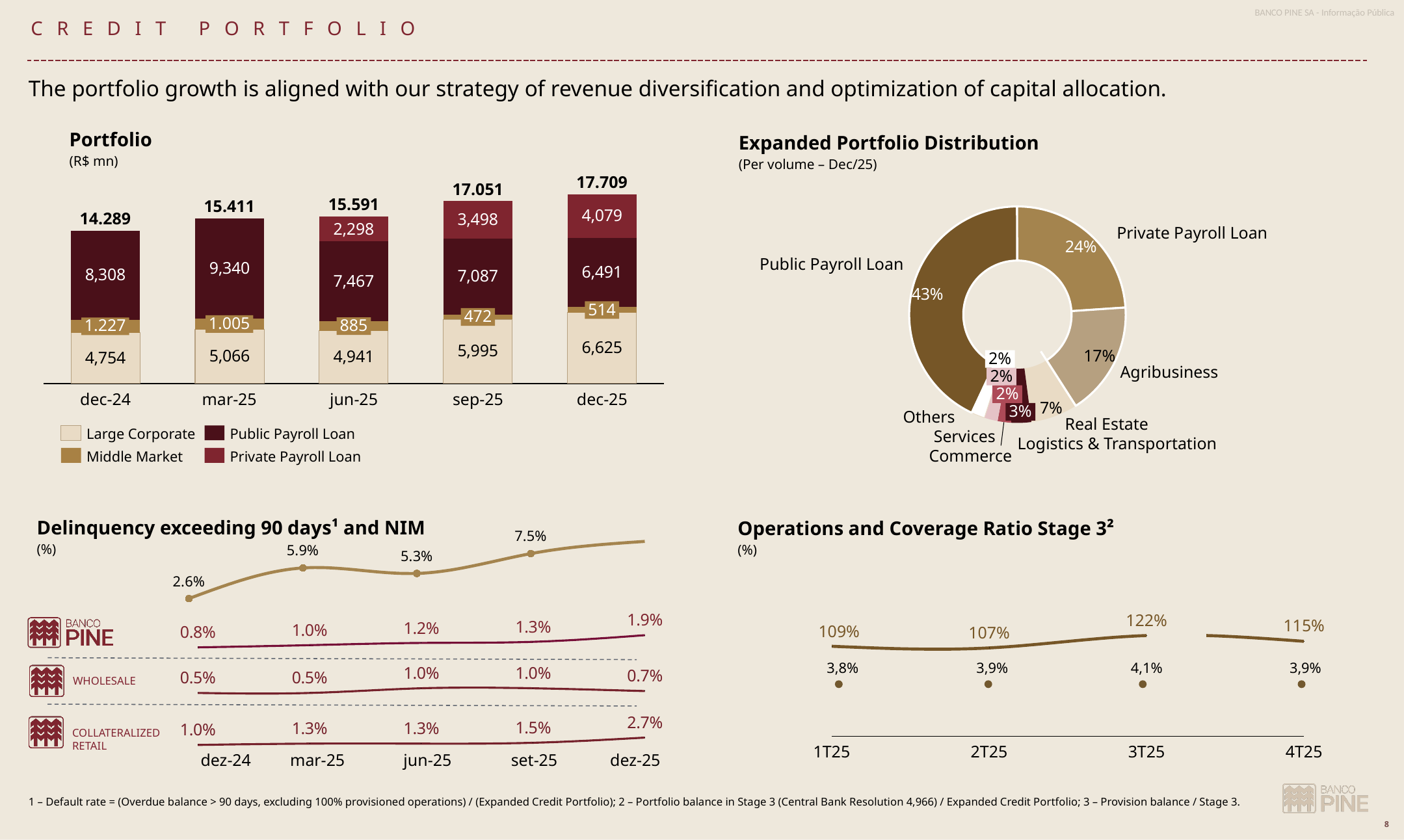
In the Operations and Coverage Ratio Stage 3 chart, what is the coverage ratio for 3T25? 122% In the Expanded Portfolio Distribution chart, what share does Agribusiness have? 17% In the Delinquency exceeding 90 days and NIM chart, which is larger at jun-25: the Banco Pine value or the Wholesale value? Banco Pine In the Portfolio chart, what is the Public Payroll Loan value for mar-25? 9,340 In the Expanded Portfolio Distribution chart, which segment is the largest? Public Payroll Loan In the Expanded Portfolio Distribution chart, what share does Public Payroll Loan have? 43% In the Delinquency exceeding 90 days and NIM chart, what is the Collateralized Retail value for dez-25? 2.7% In the Portfolio chart, what is the difference between the Large Corporate values for dec-25 and sep-25? 630 In the Portfolio chart, does the Public Payroll Loan value rise or fall from mar-25 to dec-25? fall In the Portfolio chart, which period has the lowest total portfolio? dec-24 In the Portfolio chart, what is the total portfolio value for dec-25? 17.709 In the Portfolio chart, how many series does the legend list? 4